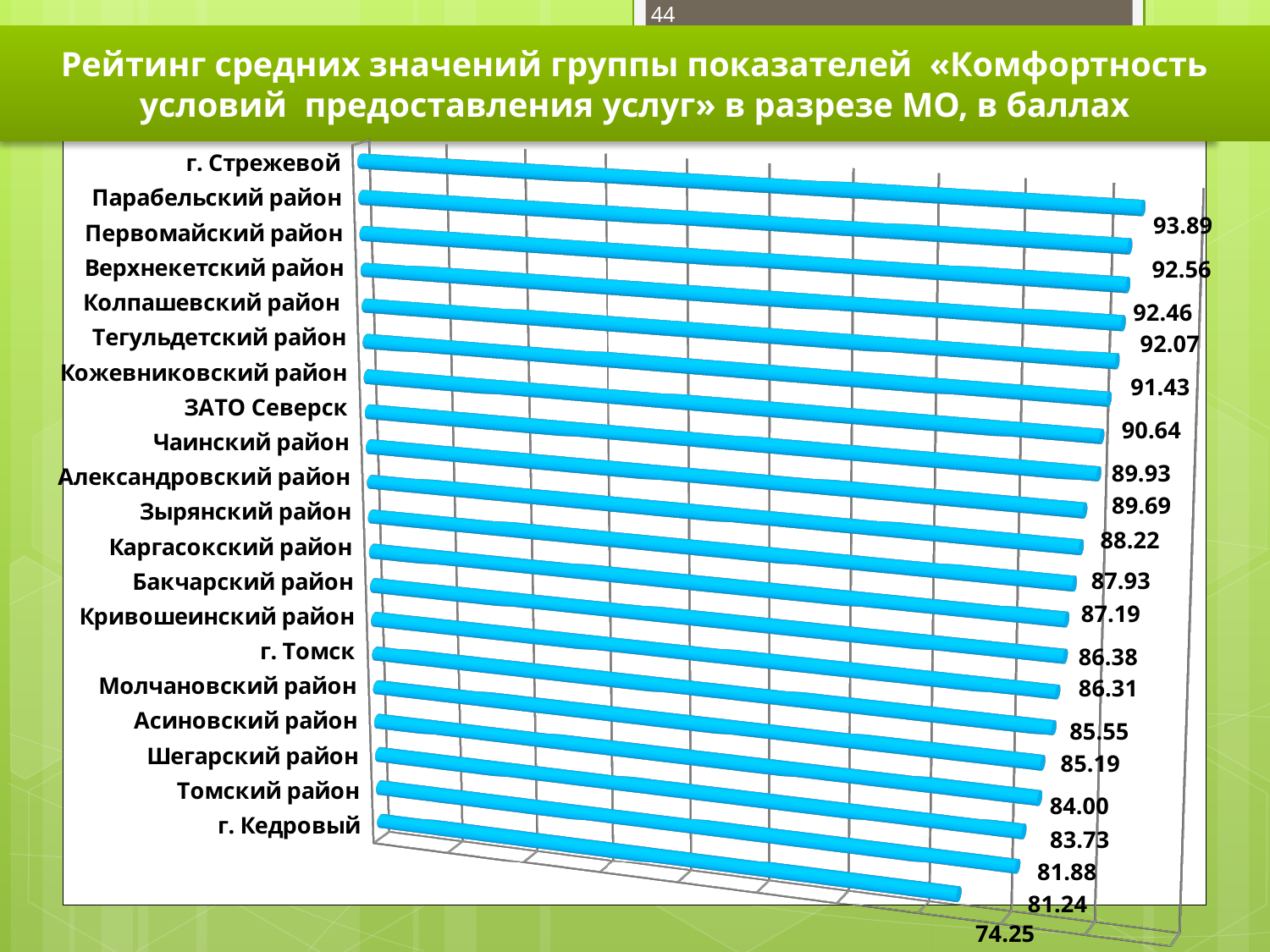
What is the value for г. Кедровый? 74.25 What is the value for Колпашевский район? 91.43 What is the value for г. Стрежевой? 93.89 How many municipalities (categories) are shown in the chart? 20 What is the difference between the values for Чаинский район and Молчановский район? 4.22 Do the values rise or fall going down the list of municipalities from top to bottom? fall What is the value for г. Томск? 85.19 What is the difference between the values for г. Стрежевой and г. Кедровый? 19.64 Which municipality has the lowest value? г. Кедровый What kind of chart is shown on the slide? bar chart Which has a larger value, Парабельский район or Томский район? Парабельский район Which municipality has the highest value? г. Стрежевой